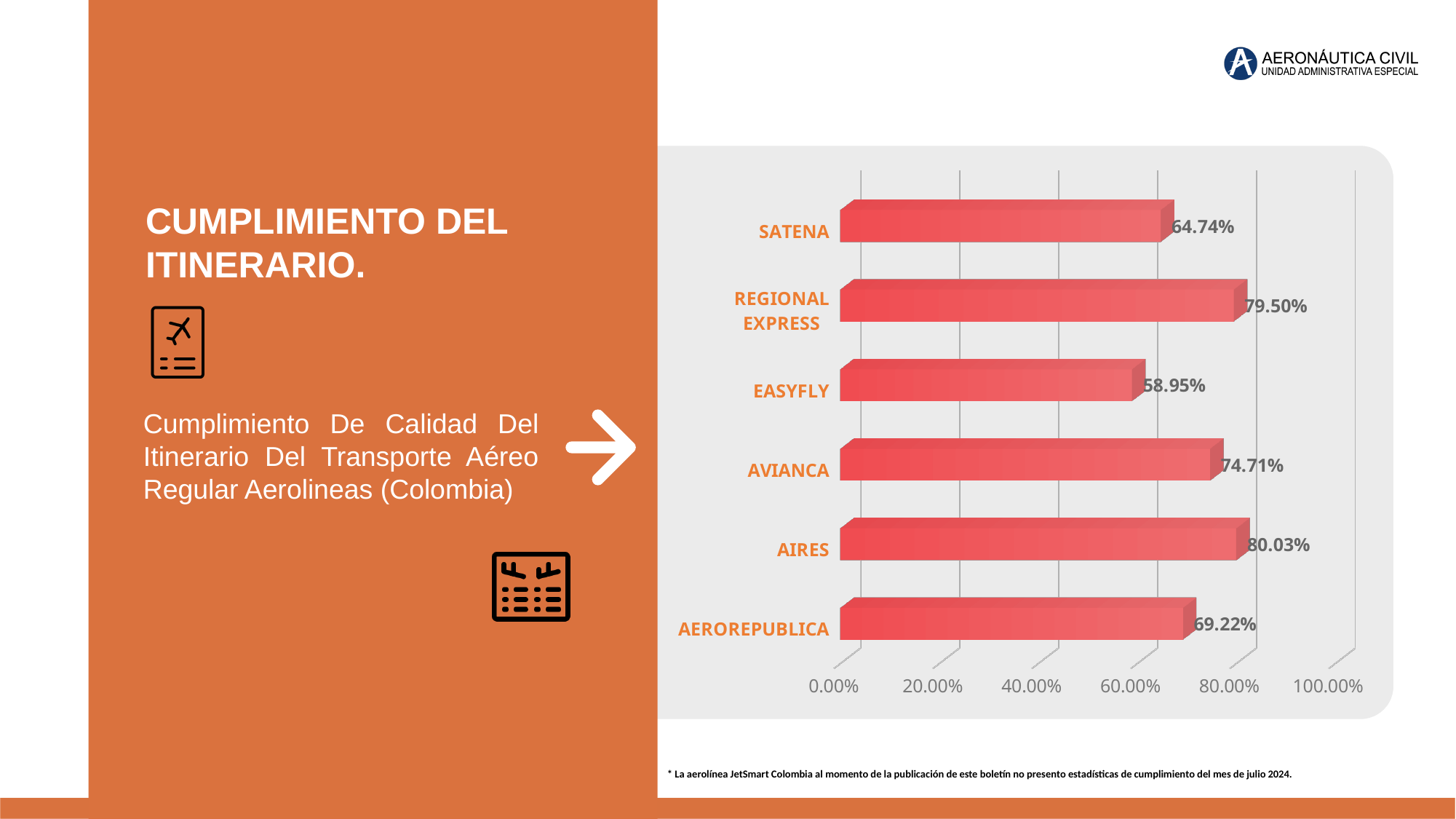
What is the value for AEROREPUBLICA? 69.22% Which airline has the lowest value? EASYFLY What is the difference between the values for REGIONAL EXPRESS and SATENA? 14.76 percentage points What is the value for AVIANCA? 74.71% Which is larger, the value for AVIANCA or the value for AEROREPUBLICA? AVIANCA What is the value for SATENA? 64.74% What kind of chart is shown on the slide? bar chart What is the value for REGIONAL EXPRESS? 79.50% What is the difference between the values for AIRES and EASYFLY? 21.08 percentage points How many airlines are shown in the chart? 6 Which airline has the highest value? AIRES Is the value for EASYFLY greater or less than 60.00%? less